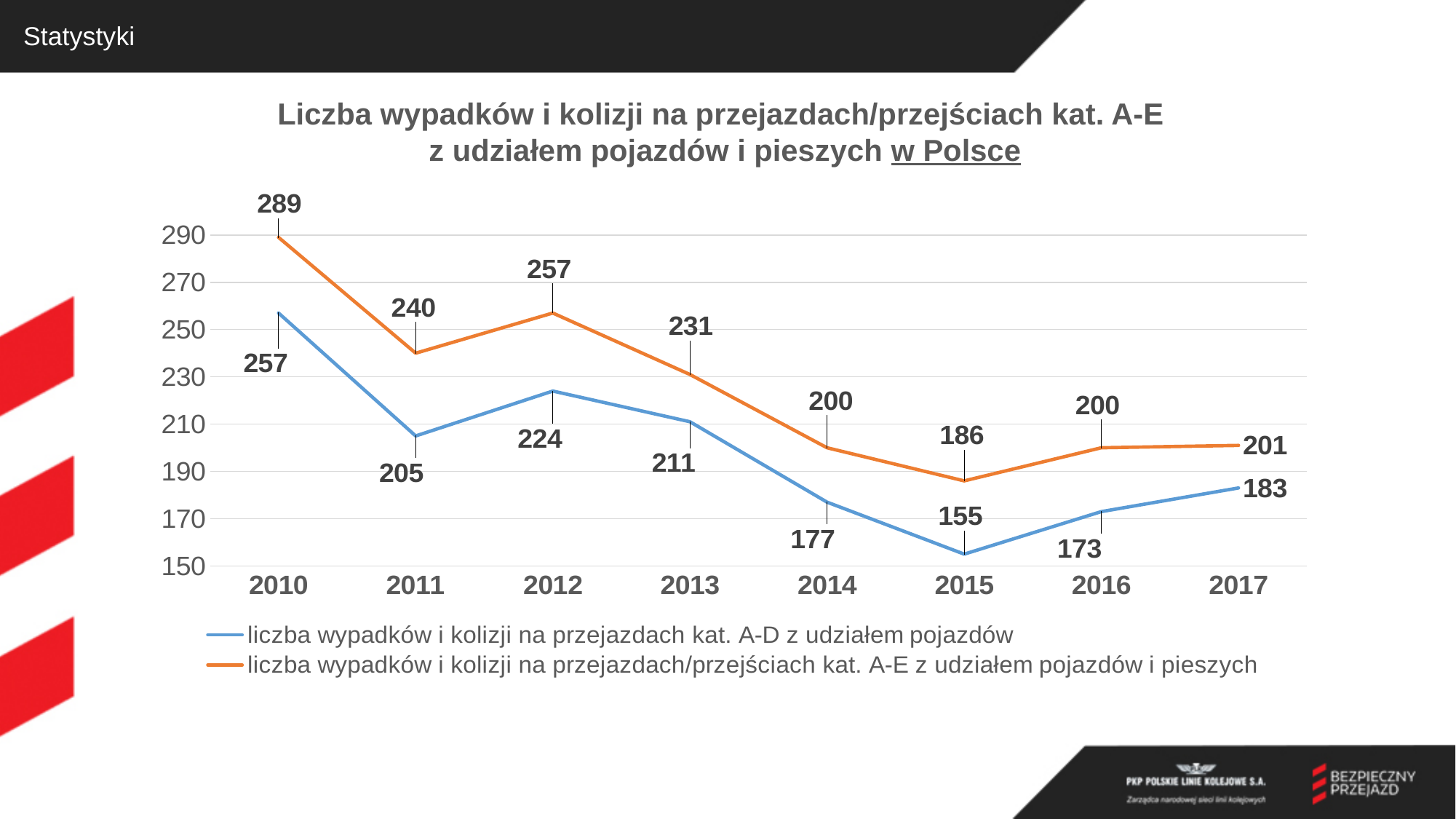
What is the value for 2010 in the series 'liczba wypadków i kolizji na przejazdach/przejściach kat. A-E z udziałem pojazdów i pieszych'? 289 In which year is the series 'liczba wypadków i kolizji na przejazdach/przejściach kat. A-E z udziałem pojazdów i pieszych' at its highest? 2010 What type of chart is shown on the slide? line chart What colour is the line for the series 'liczba wypadków i kolizji na przejazdach kat. A-D z udziałem pojazdów'? blue What is the value for 2017 in the series 'liczba wypadków i kolizji na przejazdach/przejściach kat. A-E z udziałem pojazdów i pieszych'? 201 Which is larger: the value for 2011 or the value for 2013 in the series 'liczba wypadków i kolizji na przejazdach kat. A-D z udziałem pojazdów'? 2013 In which year is the series 'liczba wypadków i kolizji na przejazdach kat. A-D z udziałem pojazdów' at its lowest? 2015 What is the difference between the two series' values in 2012? 33 Does the series 'liczba wypadków i kolizji na przejazdach/przejściach kat. A-E z udziałem pojazdów i pieszych' generally rise or fall from 2010 to 2015? fall How many series does the legend list? 2 How many years are plotted along the x axis? 8 What is the value for 2015 in the series 'liczba wypadków i kolizji na przejazdach kat. A-D z udziałem pojazdów'? 155